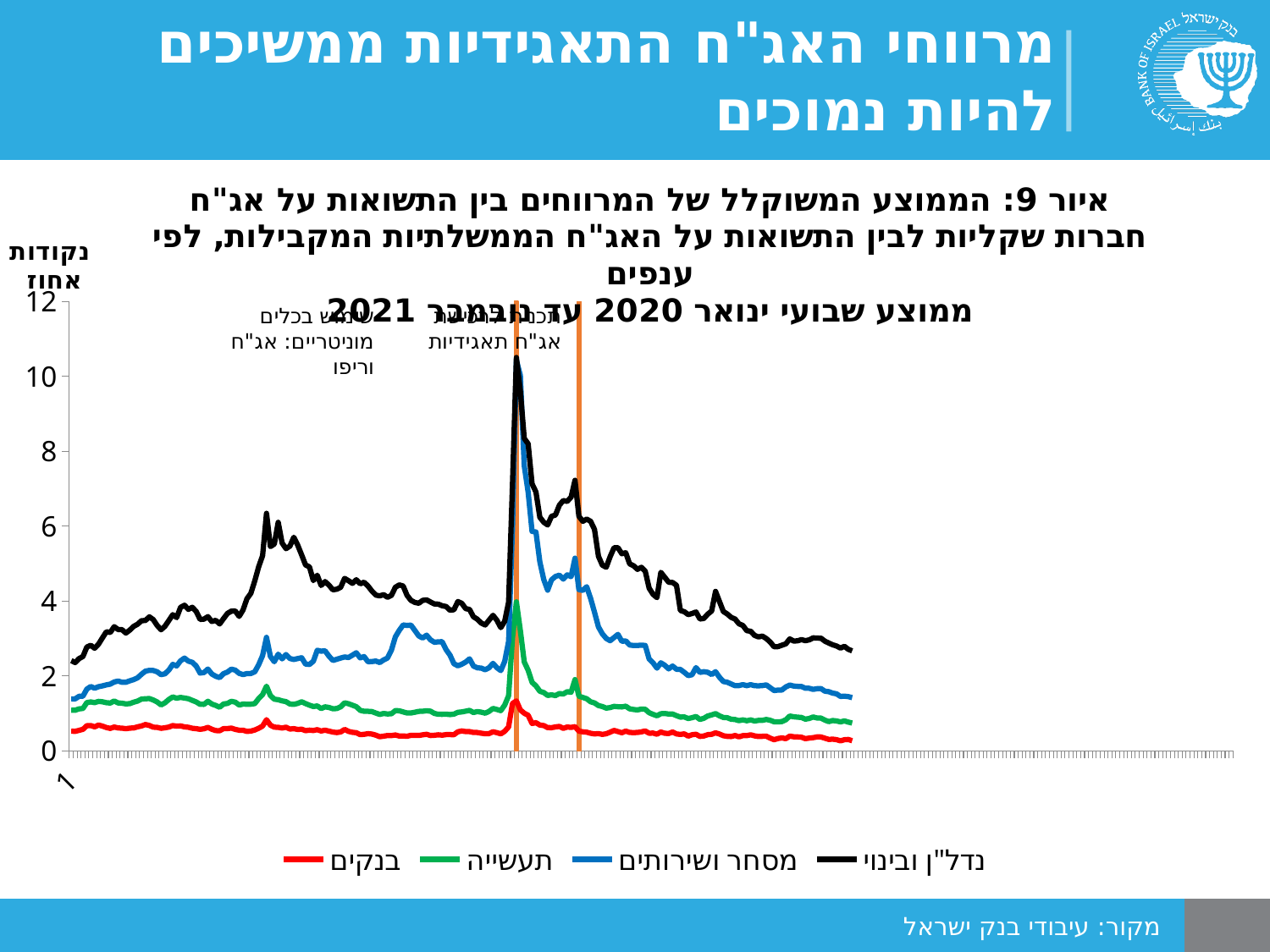
Is the peak value of the בנקים series greater or less than 2? less Is the peak value of the מסחר ושירותים series greater or less than 4? greater Which series stays lowest throughout the chart? בנקים Which series reaches the highest value on the chart? נדל"ן ובינוי Is the peak value of the תעשייה series greater or less than 6? less How many series does the legend list? 4 What colour is the line for the בנקים series? red After its highest peak, does the נדל"ן ובינוי series rise or fall toward the right end of the chart? fall Which series is higher at the right end of the chart, מסחר ושירותים or תעשייה? מסחר ושירותים What kind of chart is shown on the slide? line chart What is the highest tick value shown on the y axis? 12